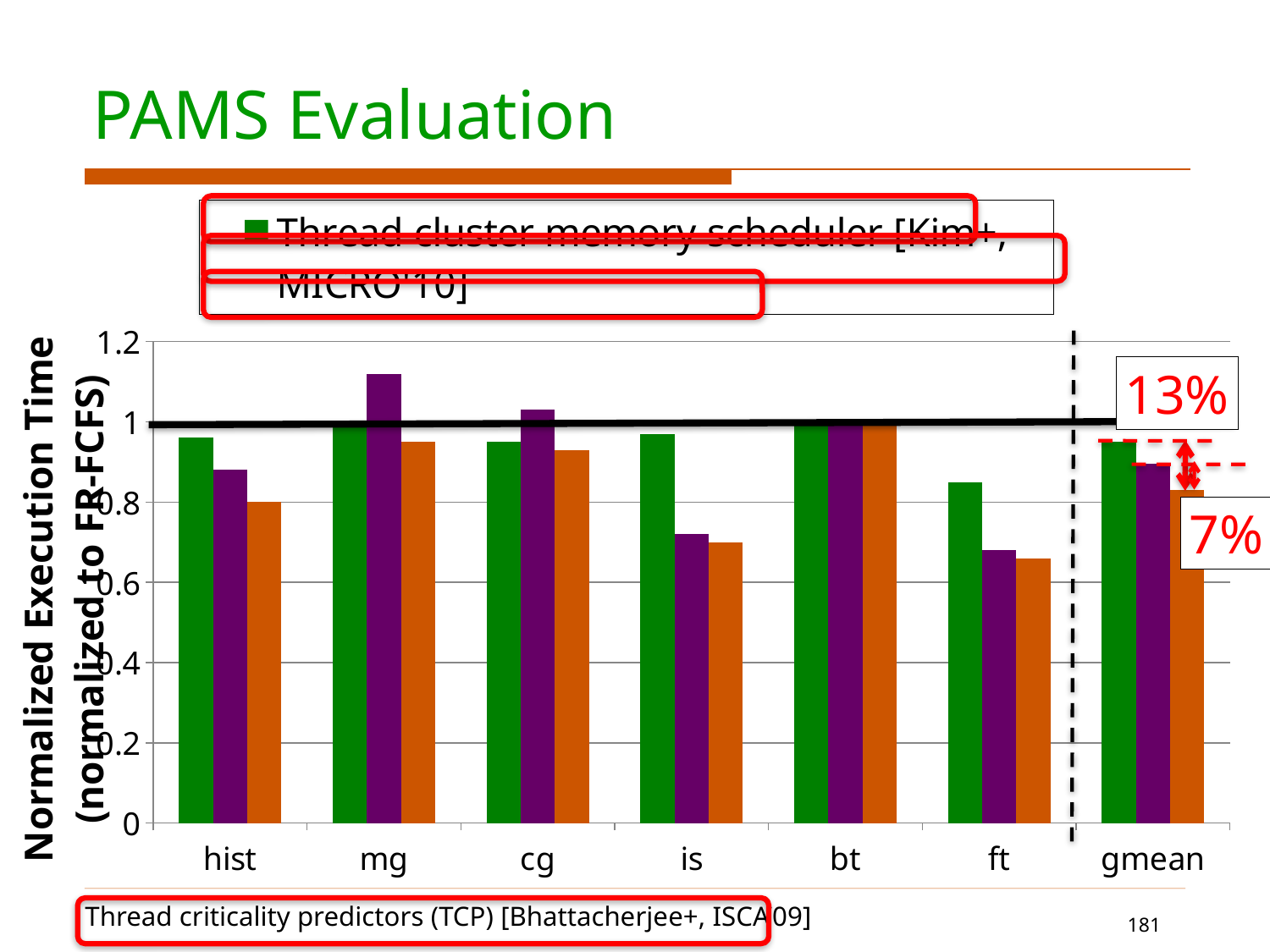
What two percentage values are annotated next to the gmean bars? 13% and 7% For hist, which is taller: the green bar or the orange bar? green Which category has the tallest purple bar? mg Is the green bar for hist greater or less than 0.8? greater What kind of chart is shown on the slide? bar chart How many bar series (colours) are plotted for each category? 3 Is the orange bar for ft greater or less than 0.8? less Is the purple bar for mg greater or less than 1? greater Which category has a taller orange bar: hist or is? hist What is the title of the y axis? Normalized Execution Time (normalized to FR-FCFS) How many categories are shown along the x axis of the chart? 7